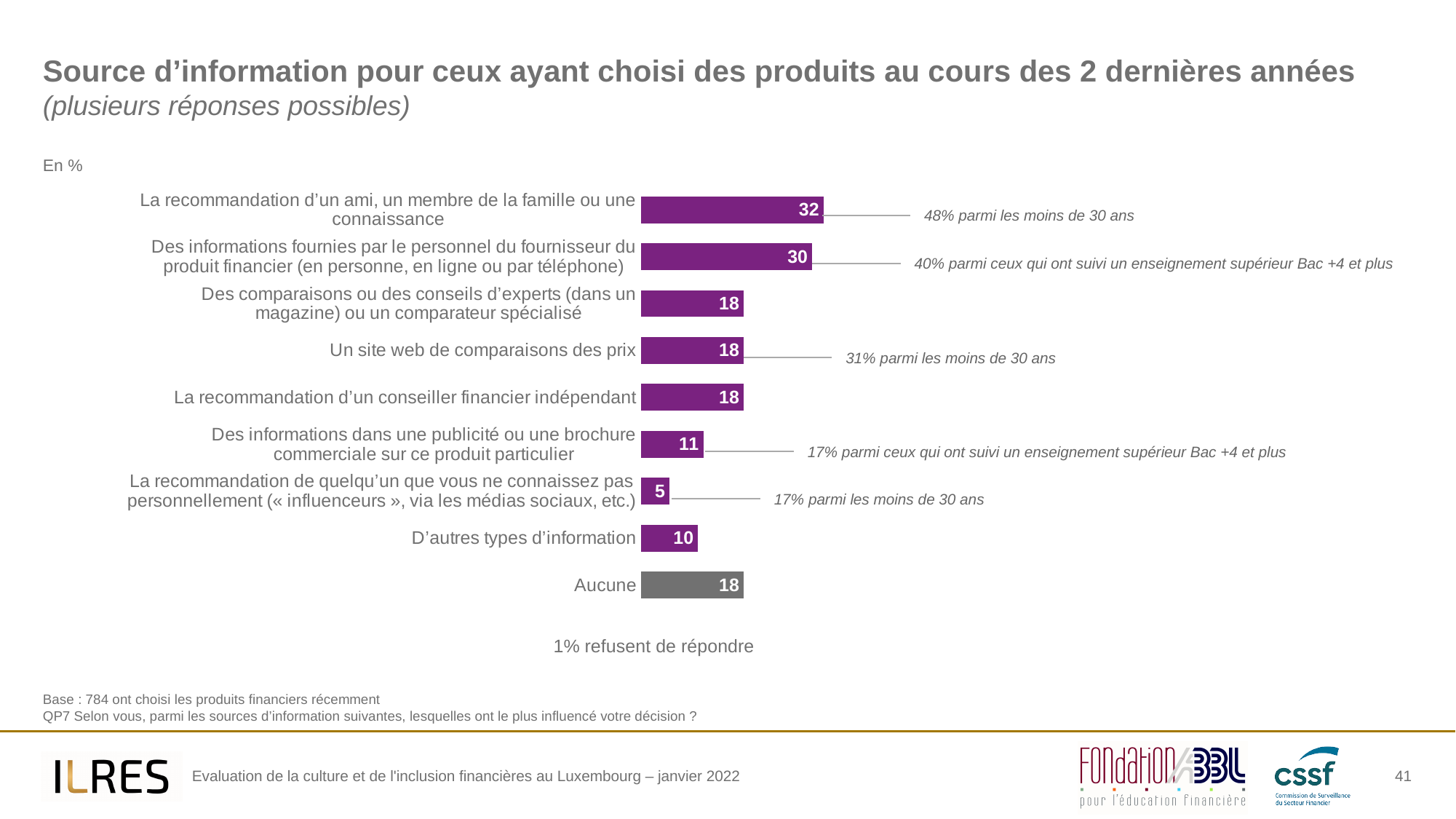
What type of chart is shown on the slide? Bar chart What value is shown for "D'autres types d'information"? 10 What is the difference between the value for "La recommandation d'un ami" and the value for "Des informations dans une publicité ou une brochure commerciale"? 21 Which category has the lowest value? La recommandation de quelqu'un que vous ne connaissez pas personnellement (« influenceurs », via les médias sociaux, etc.) What value is shown for "La recommandation d'un ami, un membre de la famille ou une connaissance"? 32 Which is larger: the value for "D'autres types d'information" or the value for "Des informations dans une publicité ou une brochure commerciale"? Des informations dans une publicité ou une brochure commerciale What value is shown for "Un site web de comparaisons des prix"? 18 Which source of information has the highest value? La recommandation d'un ami, un membre de la famille ou une connaissance How many categories (bars) are shown in the chart? 9 According to the annotation, what percentage of those under 30 cited "Un site web de comparaisons des prix"? 31% What value is shown for "Aucune"? 18 What value is shown for "Des informations fournies par le personnel du fournisseur du produit financier"? 30